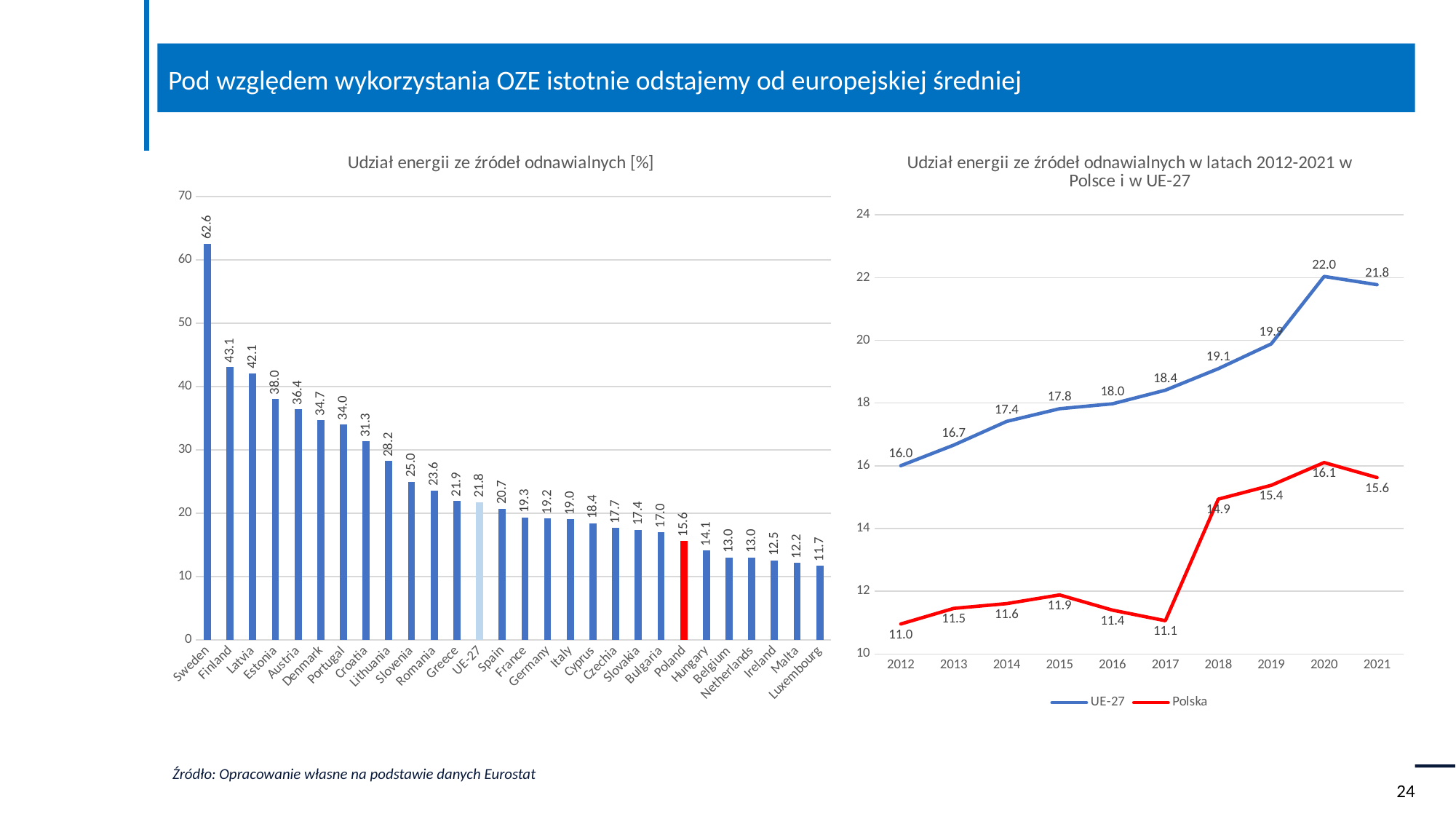
In the left chart 'Udział energii ze źródeł odnawialnych [%]', which country has the lowest value? Luxembourg In the left chart 'Udział energii ze źródeł odnawialnych [%]', how many bars are plotted? 28 In the left chart 'Udział energii ze źródeł odnawialnych [%]', which country has the highest value? Sweden In the right chart 'Udział energii ze źródeł odnawialnych w latach 2012-2021 w Polsce i w UE-27', in which year does the UE-27 series reach its highest value? 2020 In the right chart 'Udział energii ze źródeł odnawialnych w latach 2012-2021 w Polsce i w UE-27', what is the value for Polska in 2018? 14.9 In the left chart 'Udział energii ze źródeł odnawialnych [%]', what is the difference between the UE-27 value and the Poland value? 6.2 In the right chart 'Udział energii ze źródeł odnawialnych w latach 2012-2021 w Polsce i w UE-27', what is the difference between UE-27 and Polska in 2021? 6.2 How many series does the legend of the right chart 'Udział energii ze źródeł odnawialnych w latach 2012-2021 w Polsce i w UE-27' list? 2 In the left chart 'Udział energii ze źródeł odnawialnych [%]', what is the value for Poland? 15.6 In the left chart 'Udział energii ze źródeł odnawialnych [%]', which has a higher value, Finland or Latvia? Finland What kind of chart is the left chart 'Udział energii ze źródeł odnawialnych [%]'? Bar chart In the left chart 'Udział energii ze źródeł odnawialnych [%]', what colour is the bar for Poland? Red